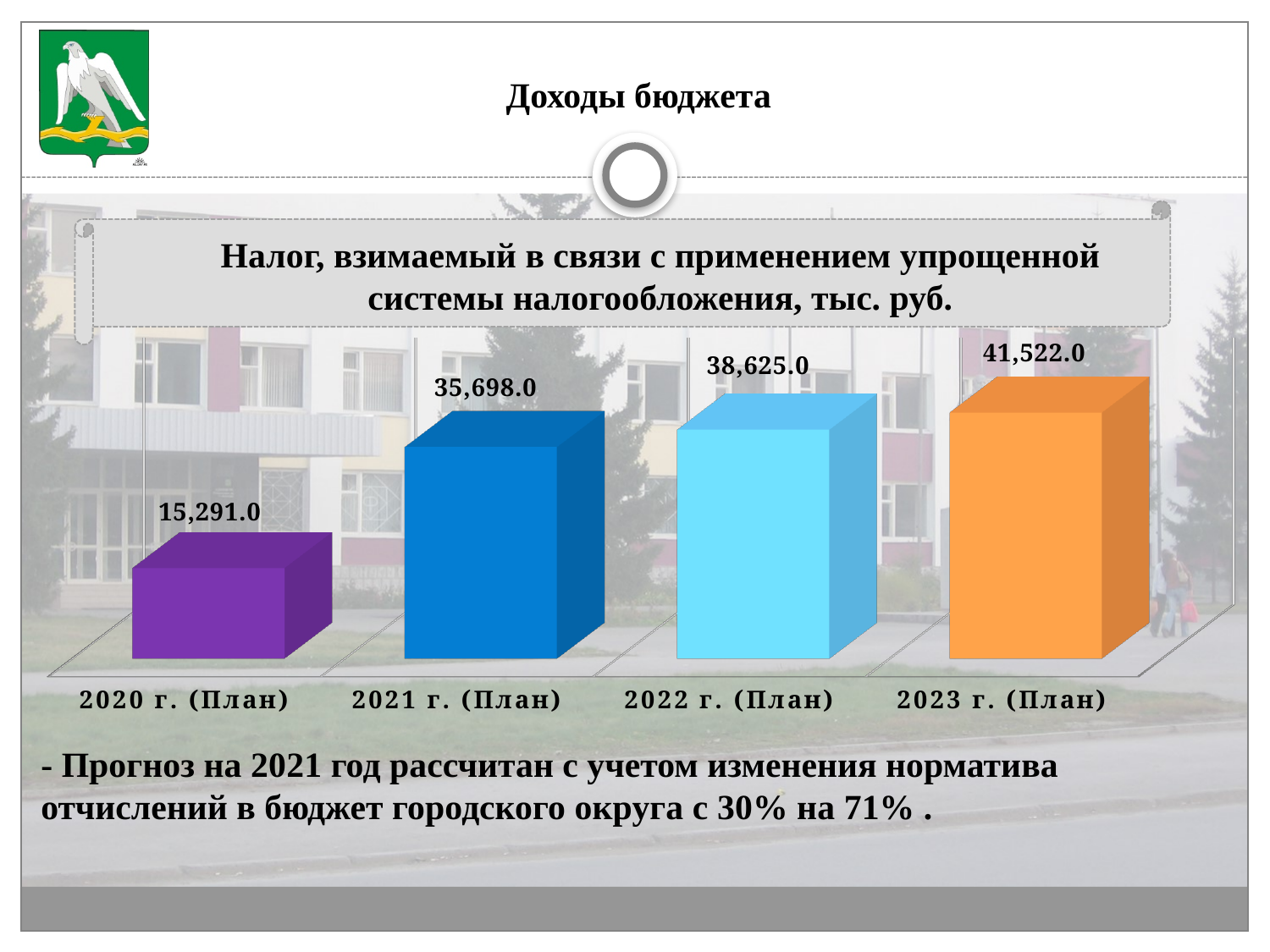
What is the value for 2020 г. (План)? 15,291.0 What is the difference between the values for 2023 г. (План) and 2022 г. (План)? 2,897.0 How many categories are shown in the chart? 4 Which category has the highest value? 2023 г. (План) Which category has the lowest value? 2020 г. (План) What is the value for 2022 г. (План)? 38,625.0 Which is larger, the value for 2022 г. (План) or the value for 2021 г. (План)? 2022 г. (План) What is the value for 2021 г. (План)? 35,698.0 What kind of chart is shown on the slide? Bar chart What is the value for 2023 г. (План)? 41,522.0 What is the difference between the values for 2021 г. (План) and 2020 г. (План)? 20,407.0 Do the values rise or fall from 2020 г. (План) to 2023 г. (План)? Rise